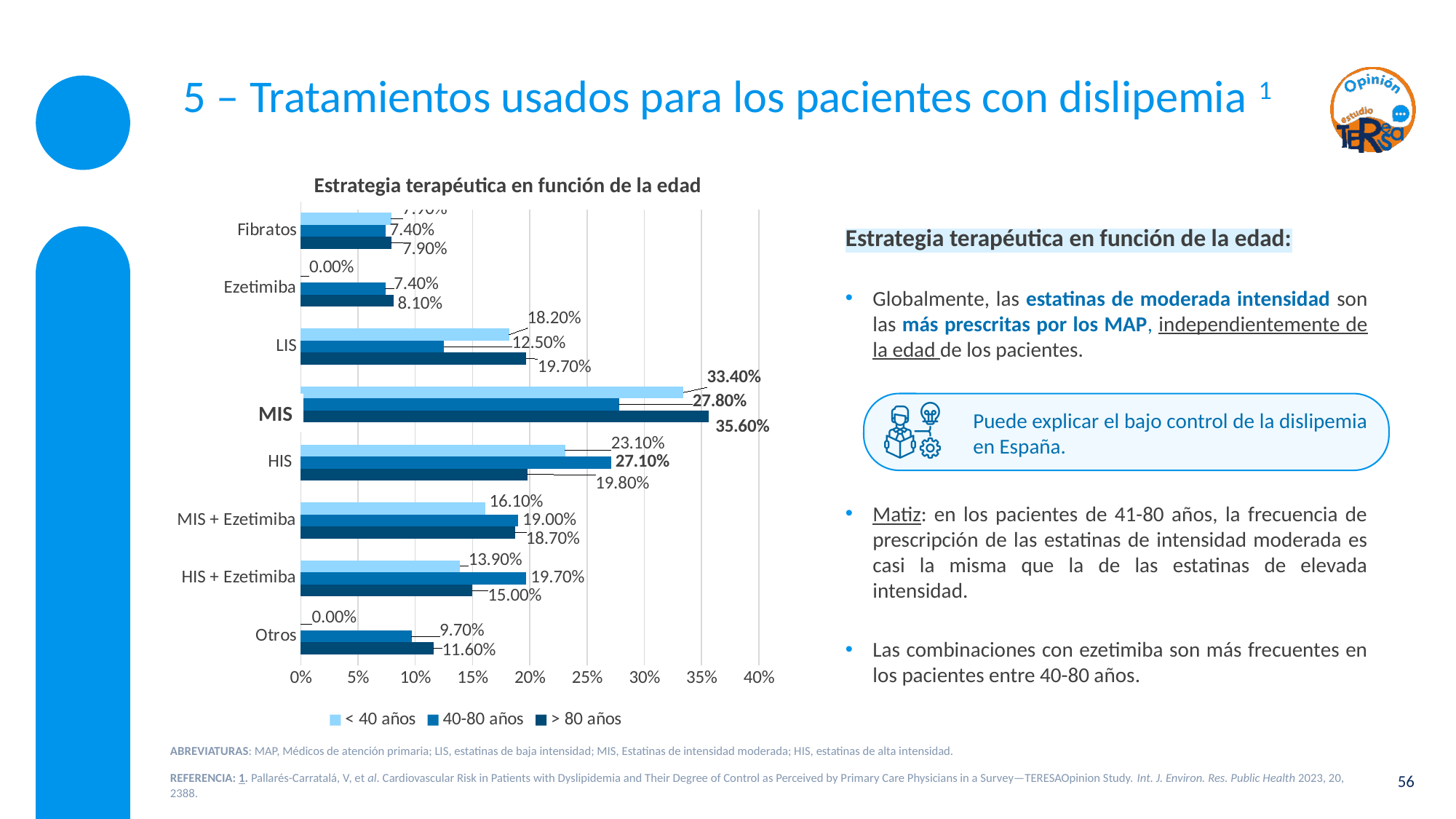
How many series does the legend list in the chart 'Estrategia terapéutica en función de la edad'? 3 How many treatment categories are shown on the chart? 8 Which treatment category has the lowest value in the '40-80 años' series? Ezetimiba and Fibratos (both 7.40%) What is the value for MIS in the '> 80 años' series? 35.60% What is the difference between the '> 80 años' and '40-80 años' values for MIS? 7.80% Which treatment category has the highest value in the '< 40 años' series? MIS For HIS + Ezetimiba, which is larger: the '40-80 años' value or the '> 80 años' value? 40-80 años What is the value for HIS in the '40-80 años' series? 27.10% What type of chart is shown on the slide? Bar chart What is the value for Otros in the '< 40 años' series? 0.00% What is the title of the chart? Estrategia terapéutica en función de la edad What is the value for LIS in the '40-80 años' series? 12.50%